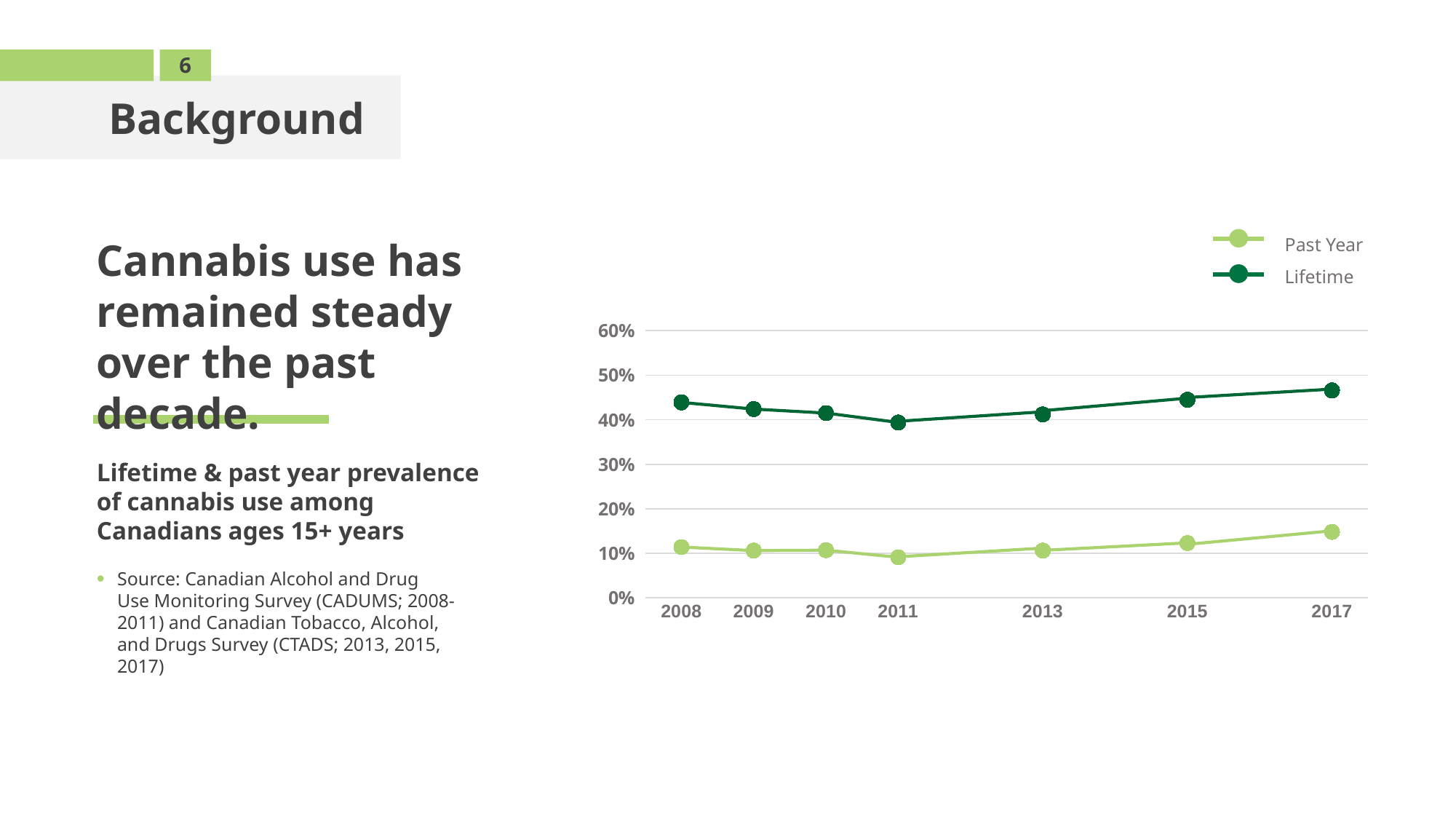
Is the Lifetime value for 2008 greater or less than 40%? greater Is the Past Year value for 2017 greater or less than 20%? less In which year is the Past Year series at its highest? 2017 In which year is the Lifetime series at its highest? 2017 In which year is the Lifetime series at its lowest? 2011 In which year is the Past Year series at its lowest? 2011 Is the Lifetime value for 2017 greater or less than 50%? less Does the Past Year series rise or fall between 2011 and 2017? rise How many years are plotted along the x axis of the chart? 7 Which series has the higher value in 2013, Past Year or Lifetime? Lifetime What kind of chart is shown on the slide? line chart How many series does the chart's legend list? 2